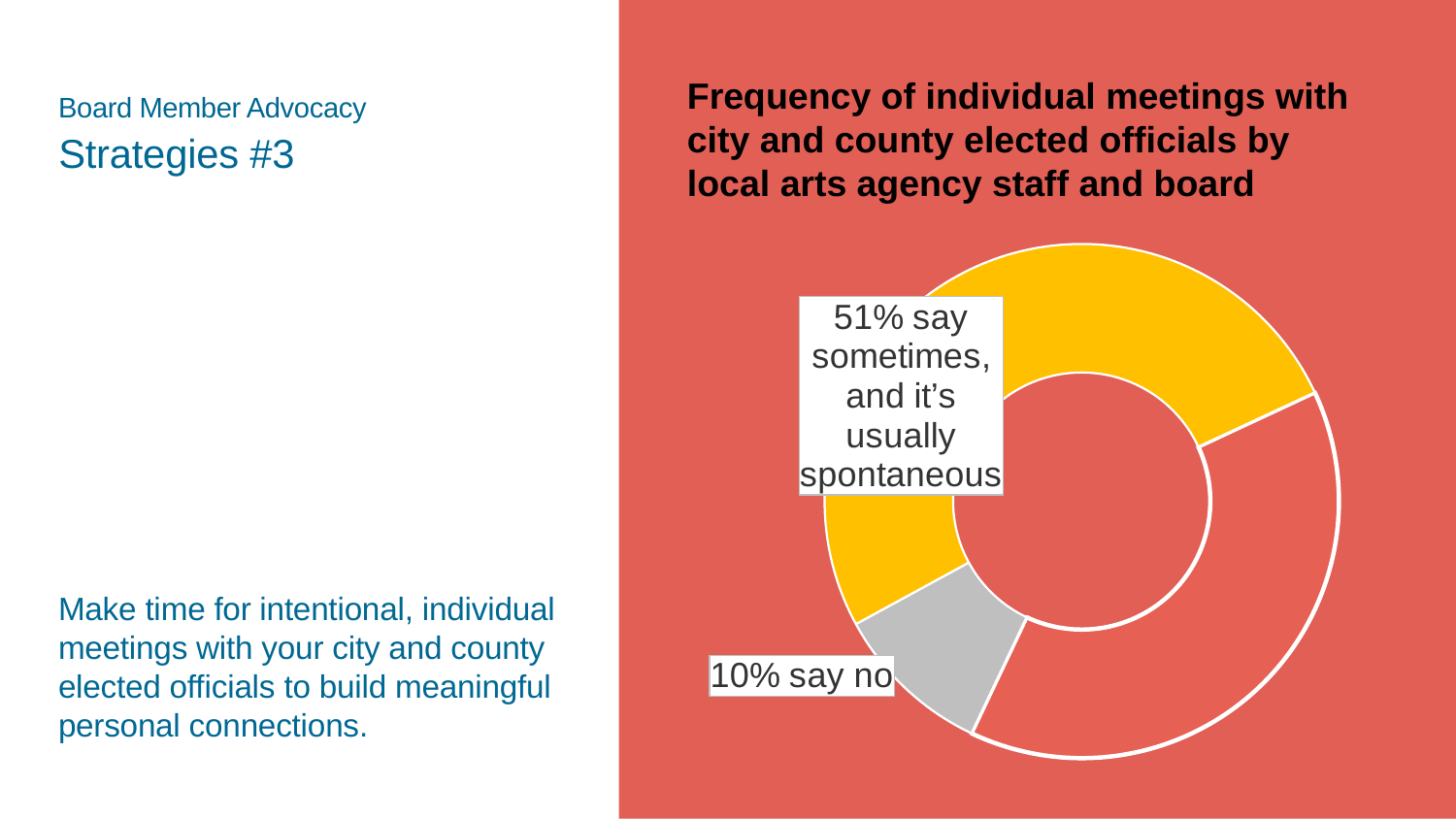
Which slice is the smallest in the chart? 10% say no Which labeled slice is the largest in the chart? 51% say sometimes What percentage of respondents say no? 10% Which is larger: the share that say sometimes or the share that say no? Say sometimes What is the difference in percentage points between the share that say sometimes and the share that say no? 41% According to the chart label, how are the 'sometimes' meetings usually described? Usually spontaneous What is the title of the chart? Frequency of individual meetings with city and county elected officials by local arts agency staff and board What kind of chart is shown on the slide? Doughnut chart How many slices does the doughnut chart have? 3 What percentage of respondents say they sometimes meet with elected officials? 51% What colour is the slice for respondents who say no? Gray